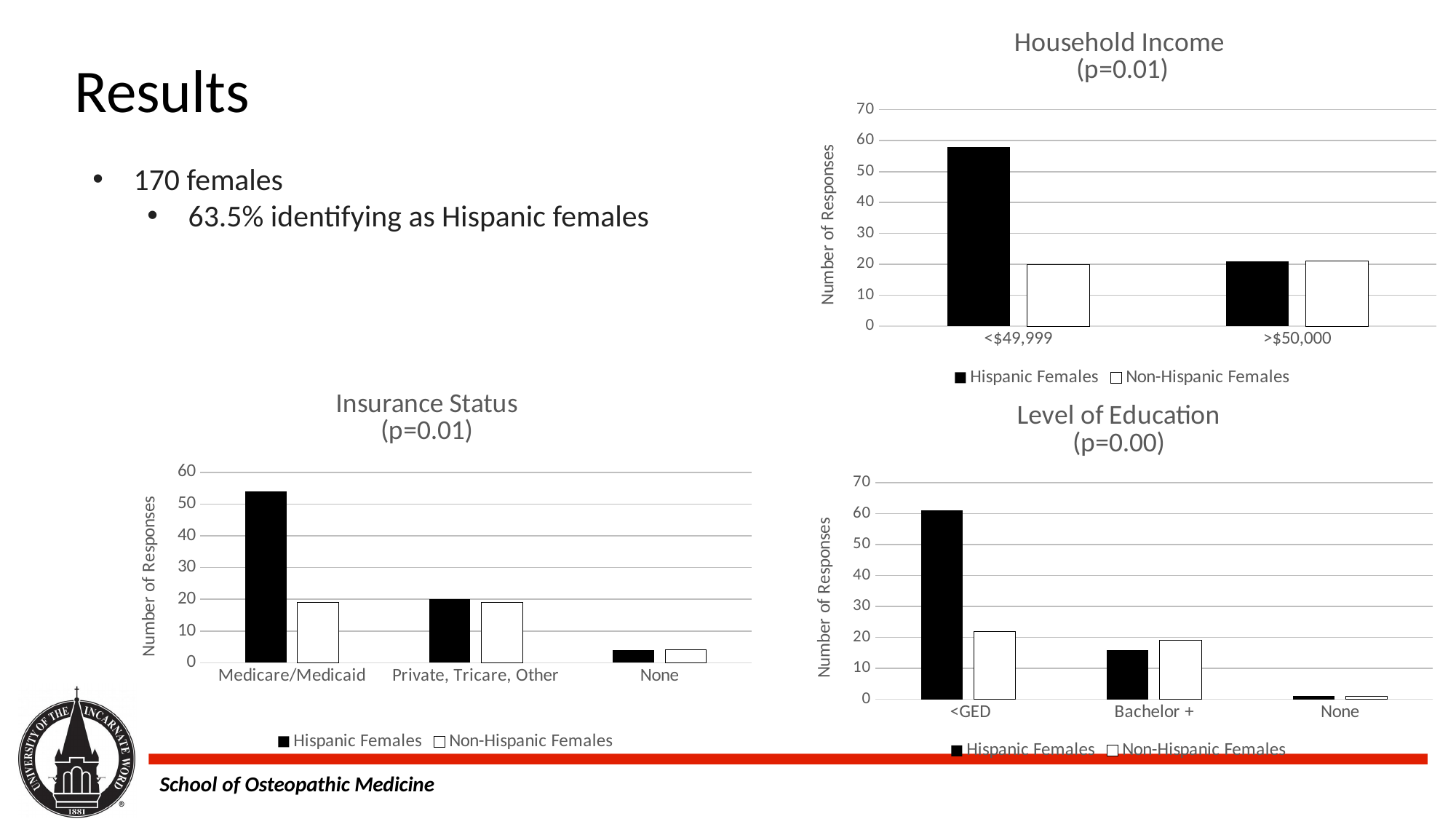
In the Household Income chart, is the value for Hispanic Females in the <$49,999 category greater or less than 50? greater In the Household Income chart, which category has the highest bar for Hispanic Females? <$49,999 What is the y-axis label of the Household Income chart? Number of Responses How many categories are shown on the x axis of the Insurance Status chart? 3 How many series does the legend of the Household Income chart list? 2 In the Insurance Status chart, which is larger for Medicare/Medicaid: Hispanic Females or Non-Hispanic Females? Hispanic Females What kind of chart is the Level of Education chart? bar chart In the Household Income chart, is the value for Non-Hispanic Females in the <$49,999 category greater or less than 30? less In the Level of Education chart, which category has the highest bar for Non-Hispanic Females? <GED In the Insurance Status chart, which category has the lowest bar for Hispanic Females? None In the Insurance Status chart, is the value for Hispanic Females in the Medicare/Medicaid category greater or less than 50? greater